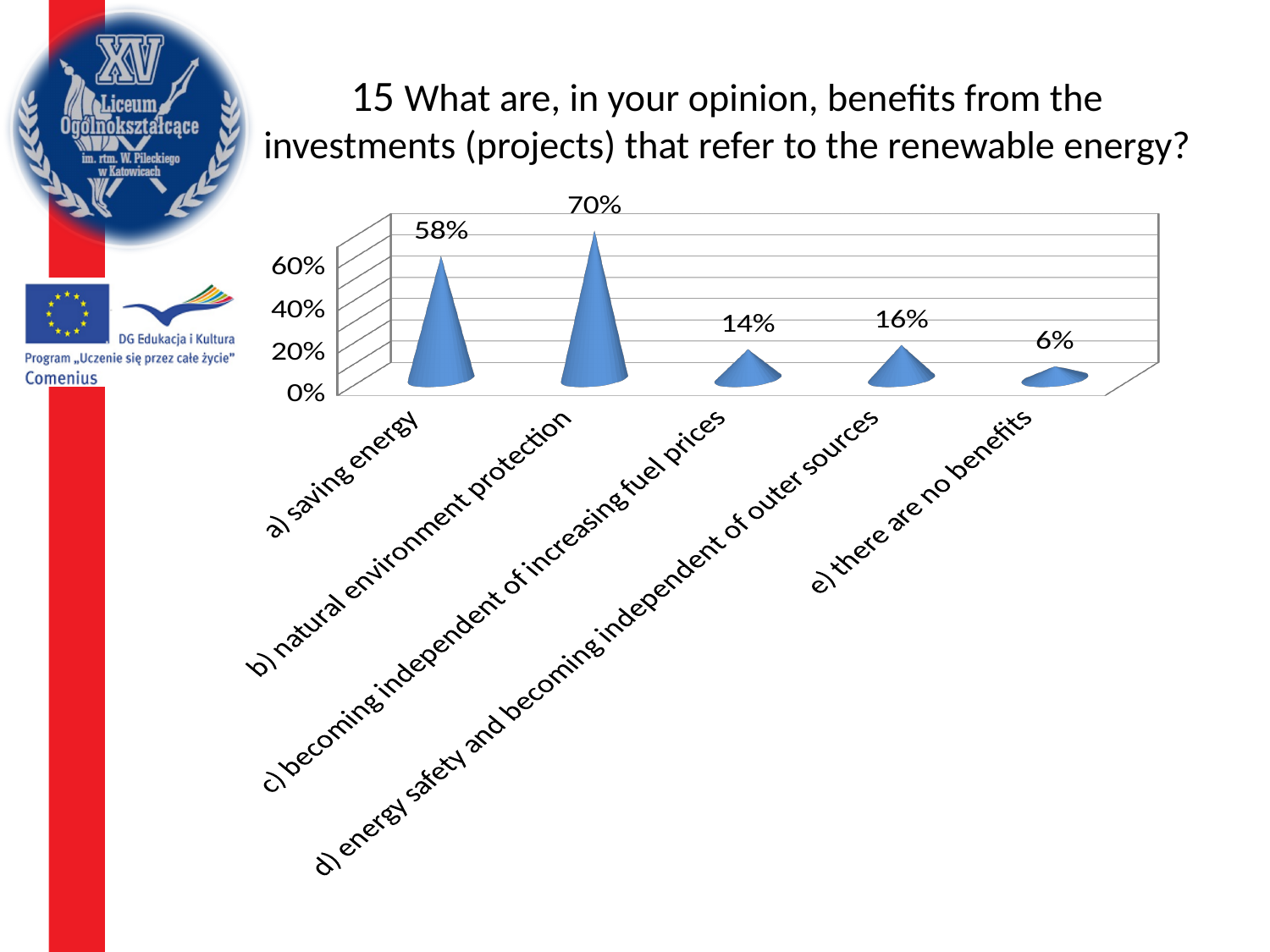
What is the value for 'b) natural environment protection'? 70% What is the value for 'c) becoming independent of increasing fuel prices'? 14% What is the difference between the values for 'd) energy safety and becoming independent of outer sources' and 'e) there are no benefits'? 10% What is the value for 'a) saving energy'? 58% What is the difference between the values for 'b) natural environment protection' and 'a) saving energy'? 12% What kind of chart is shown on the slide? bar chart Which category has the highest value? b) natural environment protection Is the value for 'a) saving energy' greater or less than 40%? greater Which category has the lowest value? e) there are no benefits How many categories are shown on the chart? 5 What is the value for 'e) there are no benefits'? 6% Which is larger: the value for 'c) becoming independent of increasing fuel prices' or 'd) energy safety and becoming independent of outer sources'? d) energy safety and becoming independent of outer sources